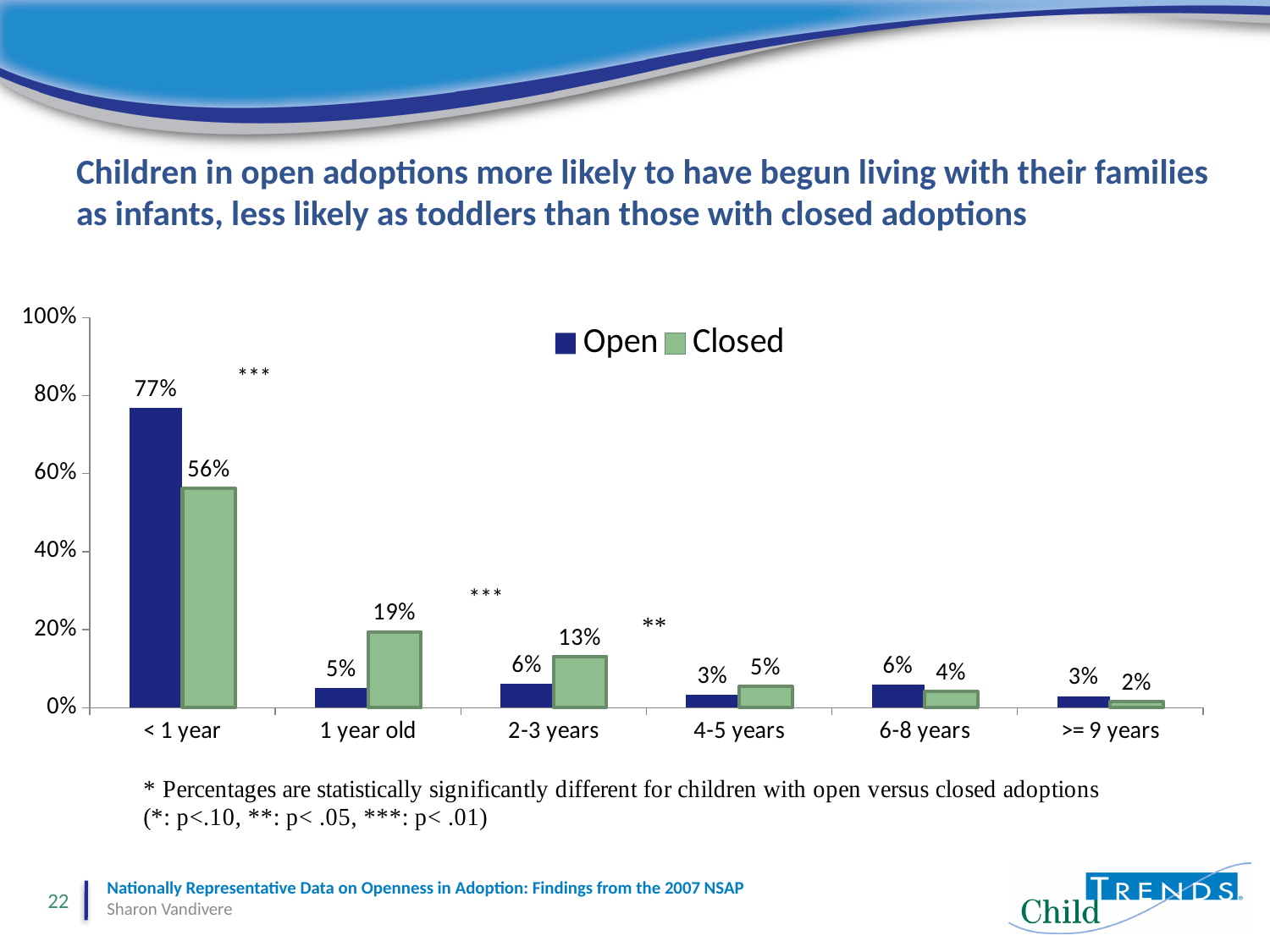
What is the Open value for the 2-3 years category? 6% Which age category has the lowest Closed value? >= 9 years What kind of chart is shown on the slide? Bar chart What percentage of children in open adoptions began living with their families at < 1 year? 77% Which age category has the highest Closed value? < 1 year How many series does the legend list? 2 How many age categories are shown on the x axis? 6 What is the Closed value for the 1 year old category? 19% Is the Open value for < 1 year greater or less than 60%? greater Which colour represents the Closed series in the chart? Green What is the difference between the Open and Closed values for the < 1 year category? 21 percentage points For the 4-5 years category, which is larger, the Open or the Closed value? Closed